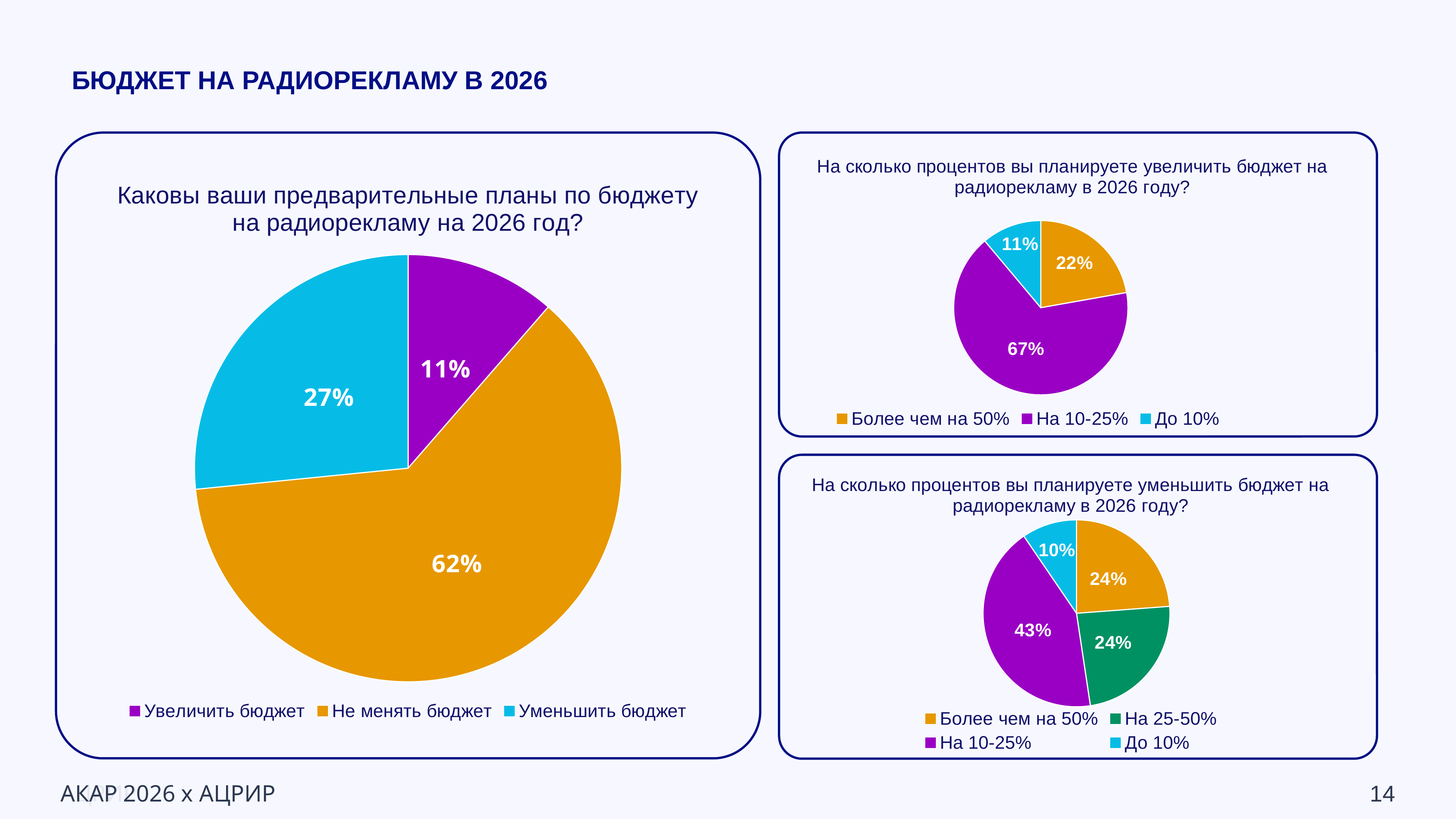
In the top-right chart 'На сколько процентов вы планируете увеличить бюджет на радиорекламу в 2026 году?', which is larger: 'Более чем на 50%' or 'До 10%'? Более чем на 50% In the left chart 'Каковы ваши предварительные планы по бюджету на радиорекламу на 2026 год?', what share of respondents chose 'Не менять бюджет'? 62% In the left chart 'Каковы ваши предварительные планы по бюджету на радиорекламу на 2026 год?', what share of respondents chose 'Уменьшить бюджет'? 27% How many categories does the legend of the top-right chart 'На сколько процентов вы планируете увеличить бюджет на радиорекламу в 2026 году?' list? 3 In the bottom-right chart 'На сколько процентов вы планируете уменьшить бюджет на радиорекламу в 2026 году?', which category has the smallest share? До 10% In the left chart 'Каковы ваши предварительные планы по бюджету на радиорекламу на 2026 год?', which category has the smallest share? Увеличить бюджет In the bottom-right chart 'На сколько процентов вы планируете уменьшить бюджет на радиорекламу в 2026 году?', what share of respondents chose 'На 10-25%'? 43% In the left chart 'Каковы ваши предварительные планы по бюджету на радиорекламу на 2026 год?', what is the difference between the shares for 'Не менять бюджет' and 'Уменьшить бюджет'? 35% How many categories does the legend of the bottom-right chart 'На сколько процентов вы планируете уменьшить бюджет на радиорекламу в 2026 году?' list? 4 In the top-right chart 'На сколько процентов вы планируете увеличить бюджет на радиорекламу в 2026 году?', which category has the largest share? На 10-25% What type of chart is used in the left panel 'Каковы ваши предварительные планы по бюджету на радиорекламу на 2026 год?'? Pie chart In the top-right chart 'На сколько процентов вы планируете увеличить бюджет на радиорекламу в 2026 году?', what share of respondents chose 'На 10-25%'? 67%